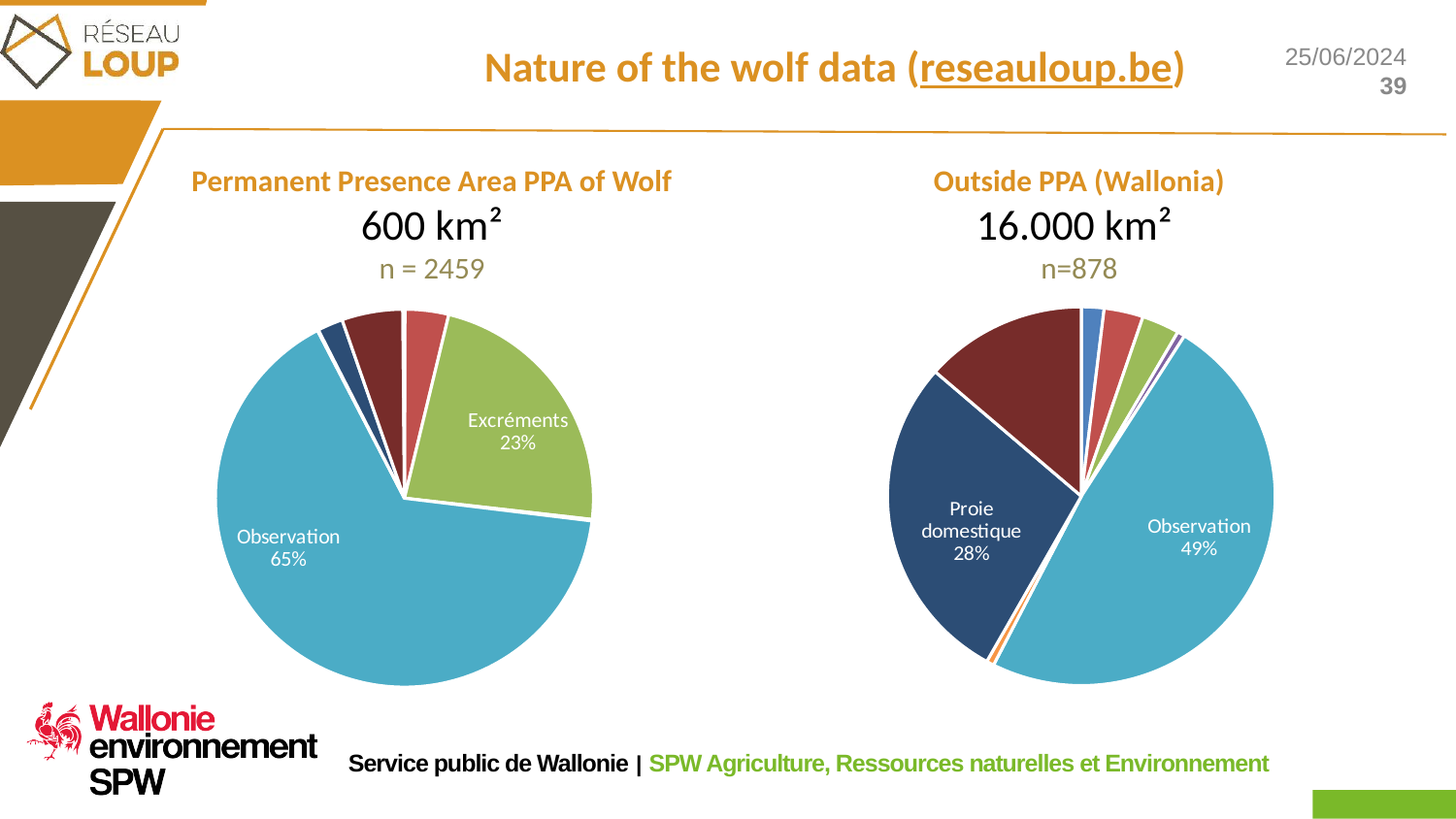
What is the sample size n shown above the Permanent Presence Area PPA of Wolf pie chart? n = 2459 In the Outside PPA (Wallonia) pie chart, which category has the largest slice? Observation In the Permanent Presence Area PPA of Wolf pie chart, how many percentage points larger is Observation than Excréments? 42 In the Permanent Presence Area PPA of Wolf pie chart, which category has the largest slice? Observation In the Outside PPA (Wallonia) pie chart, what share is Proie domestique? 28% In the Permanent Presence Area PPA of Wolf pie chart, what share is Observation? 65% What area in km² is shown above the Outside PPA (Wallonia) pie chart? 16.000 km² In the Outside PPA (Wallonia) pie chart, what share is Observation? 49% Which chart shows a larger share for Observation, the Permanent Presence Area PPA of Wolf chart or the Outside PPA (Wallonia) chart? Permanent Presence Area PPA of Wolf In the Outside PPA (Wallonia) pie chart, how many percentage points larger is Observation than Proie domestique? 21 What type of chart is used for the Outside PPA (Wallonia) data? Pie chart In the Permanent Presence Area PPA of Wolf pie chart, what share is Excréments? 23%